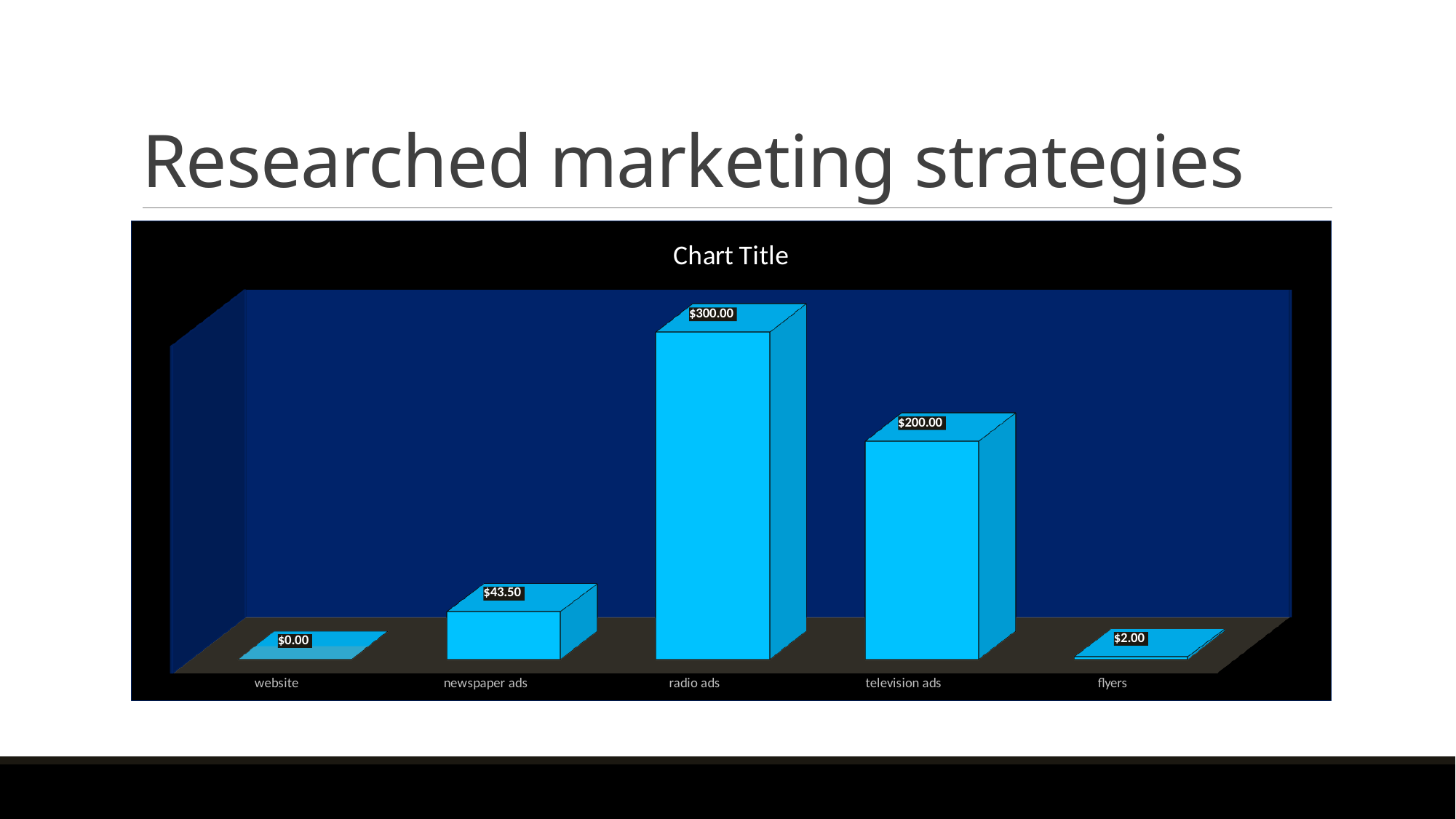
What kind of chart is shown on the slide? bar chart Which category has the lowest value? website What is the difference between the values for radio ads and television ads? $100.00 How many categories are shown on the chart? 5 What is the difference between the values for newspaper ads and flyers? $41.50 What is the value for website? $0.00 Which is larger, the value for television ads or the value for newspaper ads? television ads What is the value for television ads? $200.00 What is the value for newspaper ads? $43.50 What is the value for radio ads? $300.00 Which category has the highest value? radio ads What is the value for flyers? $2.00